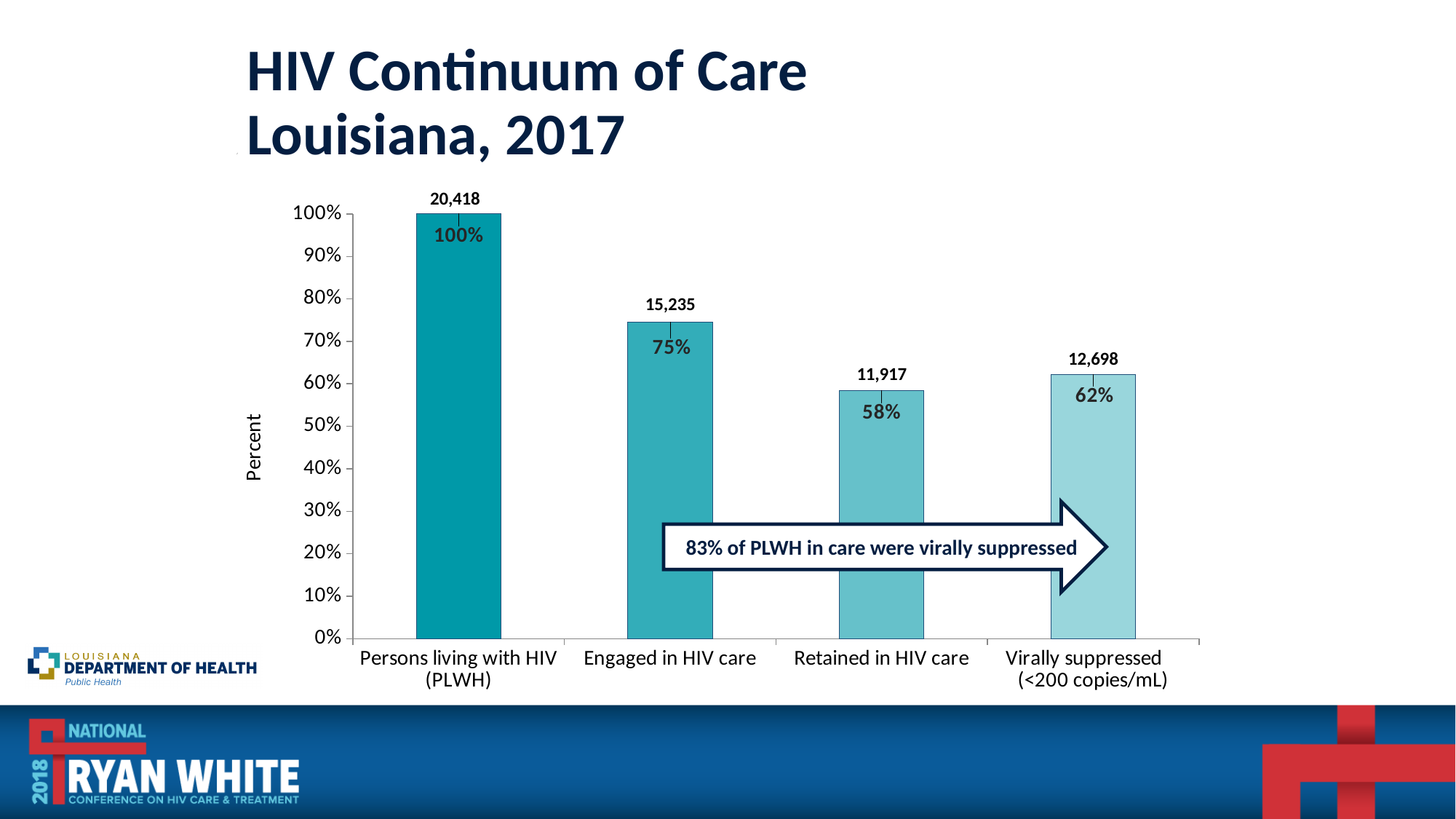
What percentage is shown for Engaged in HIV care? 75% Which category has the highest count? Persons living with HIV (PLWH) What is the difference in percentage points between Engaged in HIV care and Retained in HIV care? 17 Which is larger, the percentage for Virally suppressed or the percentage for Retained in HIV care? Virally suppressed According to the arrow annotation, what percentage of PLWH in care were virally suppressed? 83% What kind of chart is shown on the slide? Bar chart What is the count shown for Virally suppressed (<200 copies/mL)? 12,698 How many persons are shown as Retained in HIV care? 11,917 What is the difference between the counts for Persons living with HIV (PLWH) and Engaged in HIV care? 5,183 Which category has the lowest percentage? Retained in HIV care How many categories are shown on the x axis? 4 What percentage is shown for Persons living with HIV (PLWH)? 100%